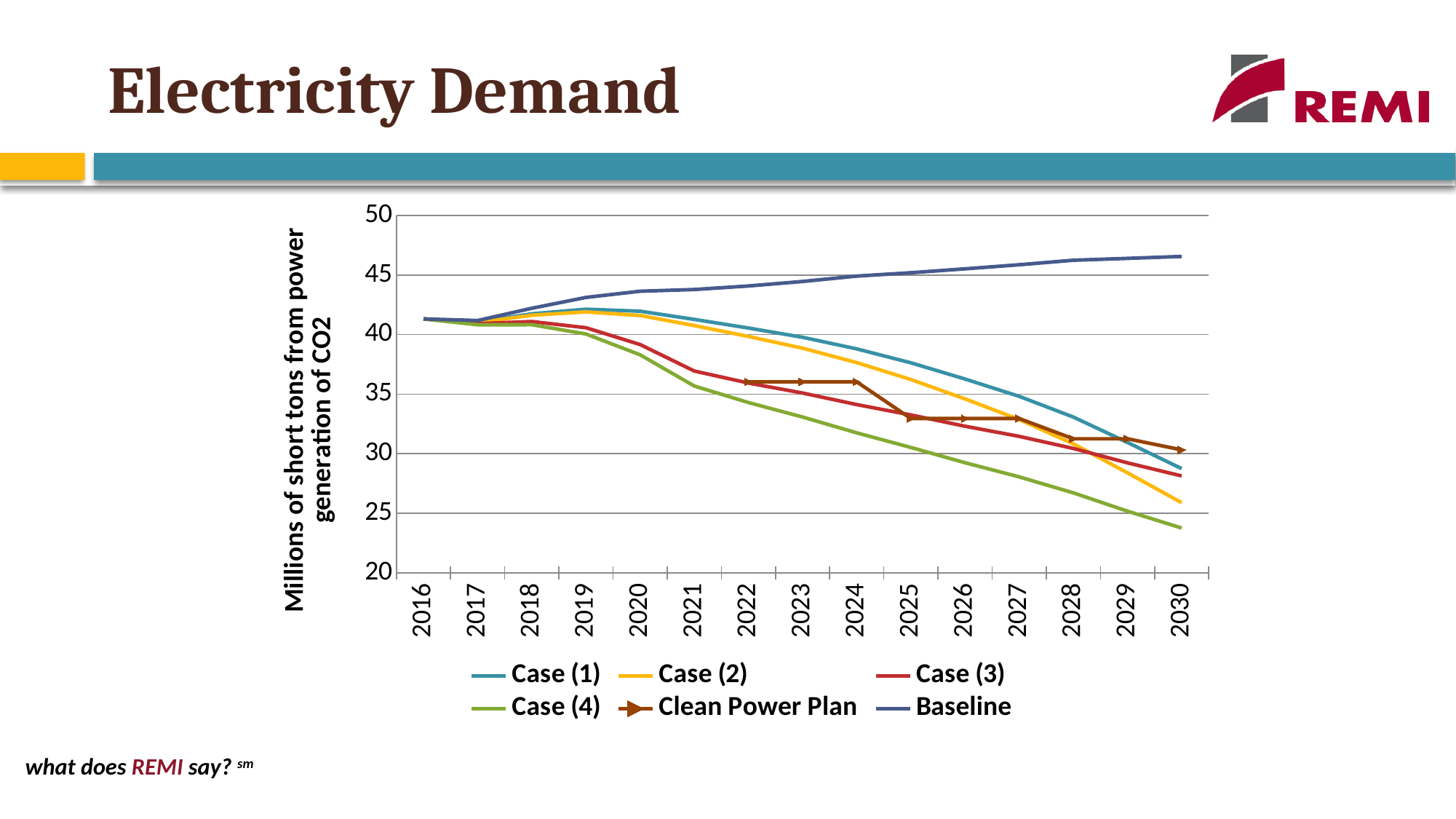
Is the value for Case (4) in 2030 greater or less than 25? less In 2030, which is larger: Case (1) or Case (2)? Case (1) What kind of chart is shown on the slide? line chart Is the value for Case (1) in 2025 greater or less than 35? greater Does the Baseline series rise or fall from 2016 to 2030? rise What is the title of the vertical axis? Millions of short tons from power generation of CO2 Is the value for Baseline in 2030 greater or less than 45? greater Which series has the lowest value in 2030? Case (4) How many years are shown along the x axis? 15 Does the Case (4) series rise or fall from 2019 to 2030? fall Which series has the highest value in 2030? Baseline How many series does the legend list? 6